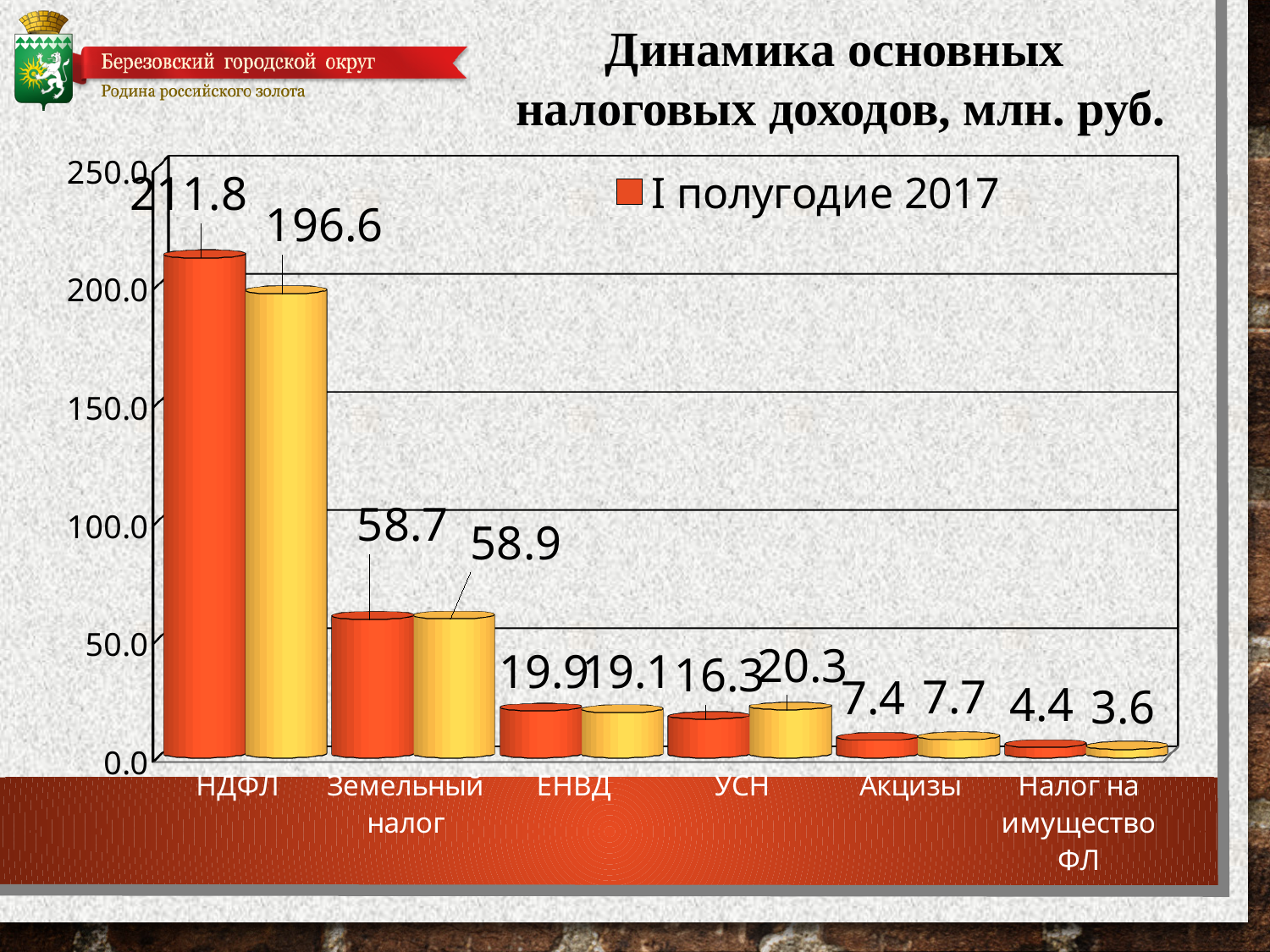
What is the value for НДФЛ in the I полугодие 2017 series? 211.8 What is the value of the yellow bar for УСН? 20.3 For УСН, which bar is larger: the orange bar or the yellow bar? the yellow bar (20.3) What is the value of the orange (I полугодие 2017) bar for Земельный налог? 58.7 Is the value for НДФЛ in the I полугодие 2017 series greater or less than 200? greater Which category has the highest value in the I полугодие 2017 series? НДФЛ What is the value of the yellow bar for Налог на имущество ФЛ? 3.6 How many categories are shown on the x axis? 6 Which category has the lowest value in the I полугодие 2017 series? Налог на имущество ФЛ What kind of chart is shown on the slide? bar chart What is the difference between the orange bar (211.8) and the yellow bar (196.6) for НДФЛ? 15.2 What is the title of the chart? Динамика основных налоговых доходов, млн. руб.